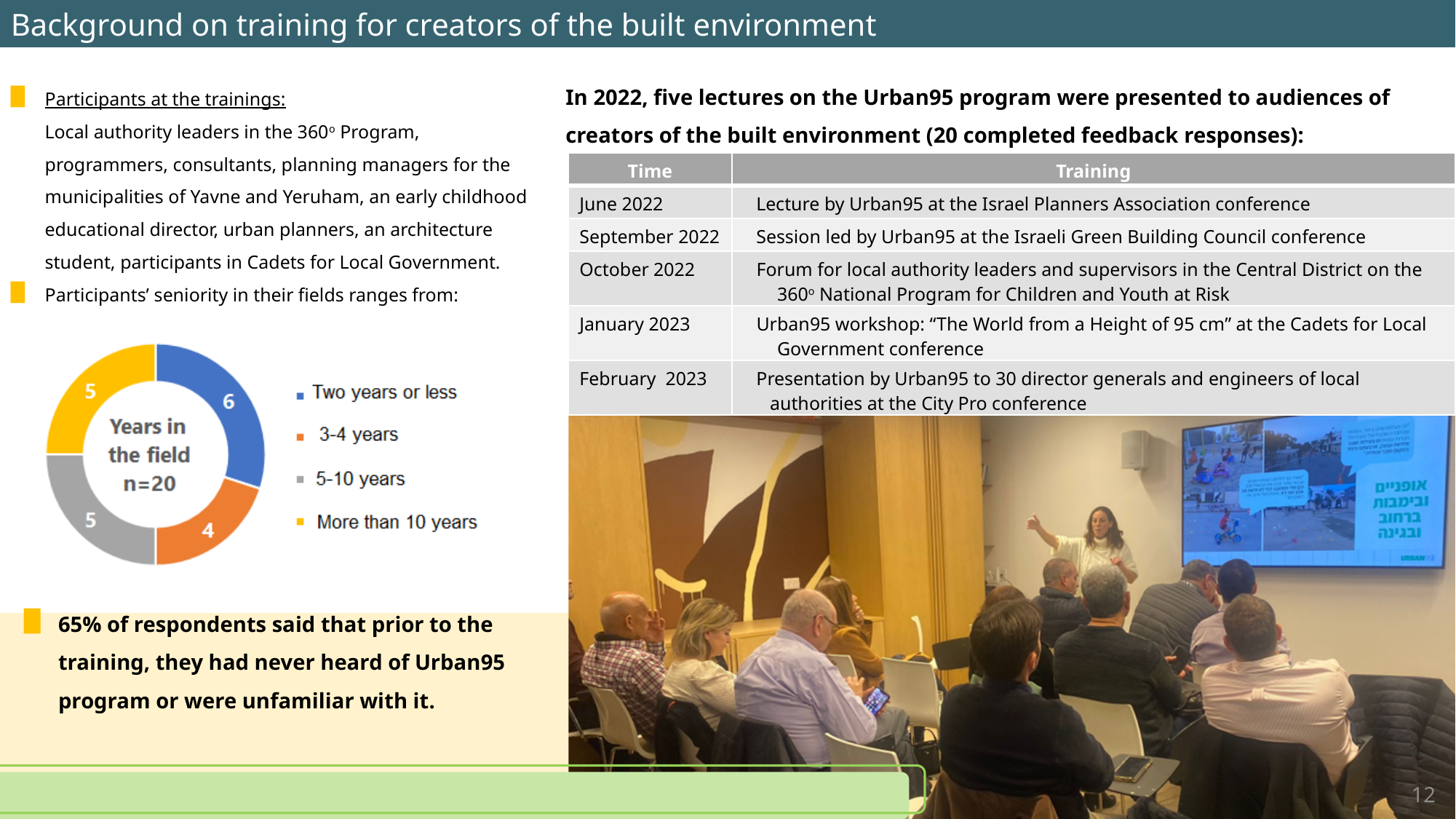
What kind of chart is shown on the slide? Donut (pie) chart What is the difference between the number of participants with two years or less and those with 3-4 years? 2 How many participants have 5-10 years in the field? 5 How many participants have two years or less in the field? 6 What is the sample size (n) stated in the centre of the donut chart? n=20 How many participants have more than 10 years in the field? 5 What share of the participants have two years or less in the field? 30% How many participants have 3-4 years in the field? 4 How many categories does the donut chart show? 4 Which seniority category has the fewest participants? 3-4 years Which seniority category has the most participants? Two years or less Which is larger: the number of participants with two years or less, or those with 5-10 years? Two years or less